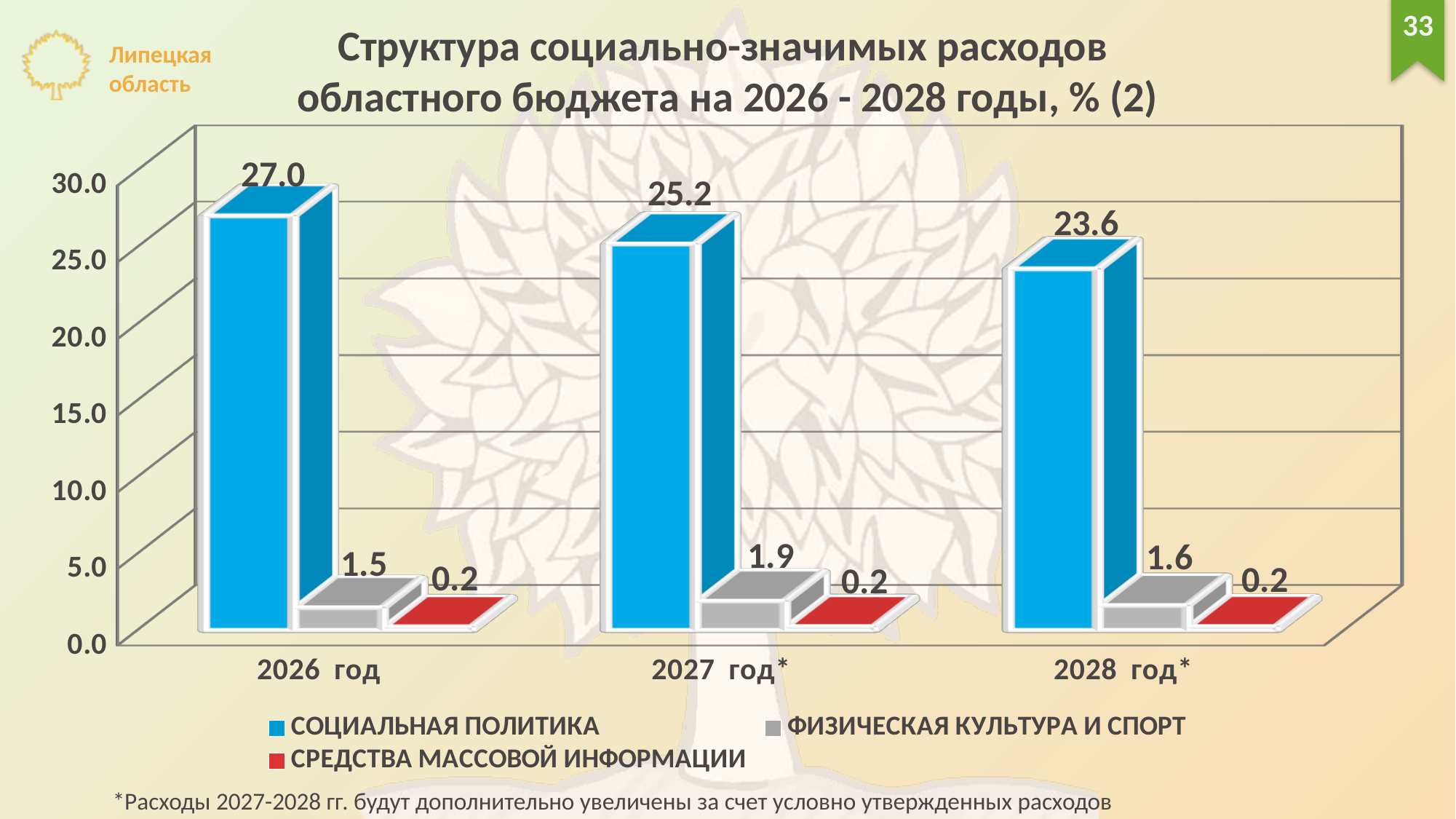
What is the value for Социальная политика in 2026 год? 27.0 What is the difference between the Социальная политика values for 2026 год and 2028 год*? 3.4 Is the value for Социальная политика in 2027 год* greater or less than 25.0? greater What is the value for Средства массовой информации in 2028 год*? 0.2 What is the value for Физическая культура и спорт in 2027 год*? 1.9 How many series does the legend list? 3 Which is larger: Физическая культура и спорт in 2027 год* or in 2028 год*? 2027 год* How many year categories are shown on the x axis? 3 In which year is the value for Социальная политика the highest? 2026 год What kind of chart is shown on the slide? Bar chart In which year is the value for Физическая культура и спорт the lowest? 2026 год Does the value for Социальная политика rise or fall from 2026 год to 2028 год*? Fall